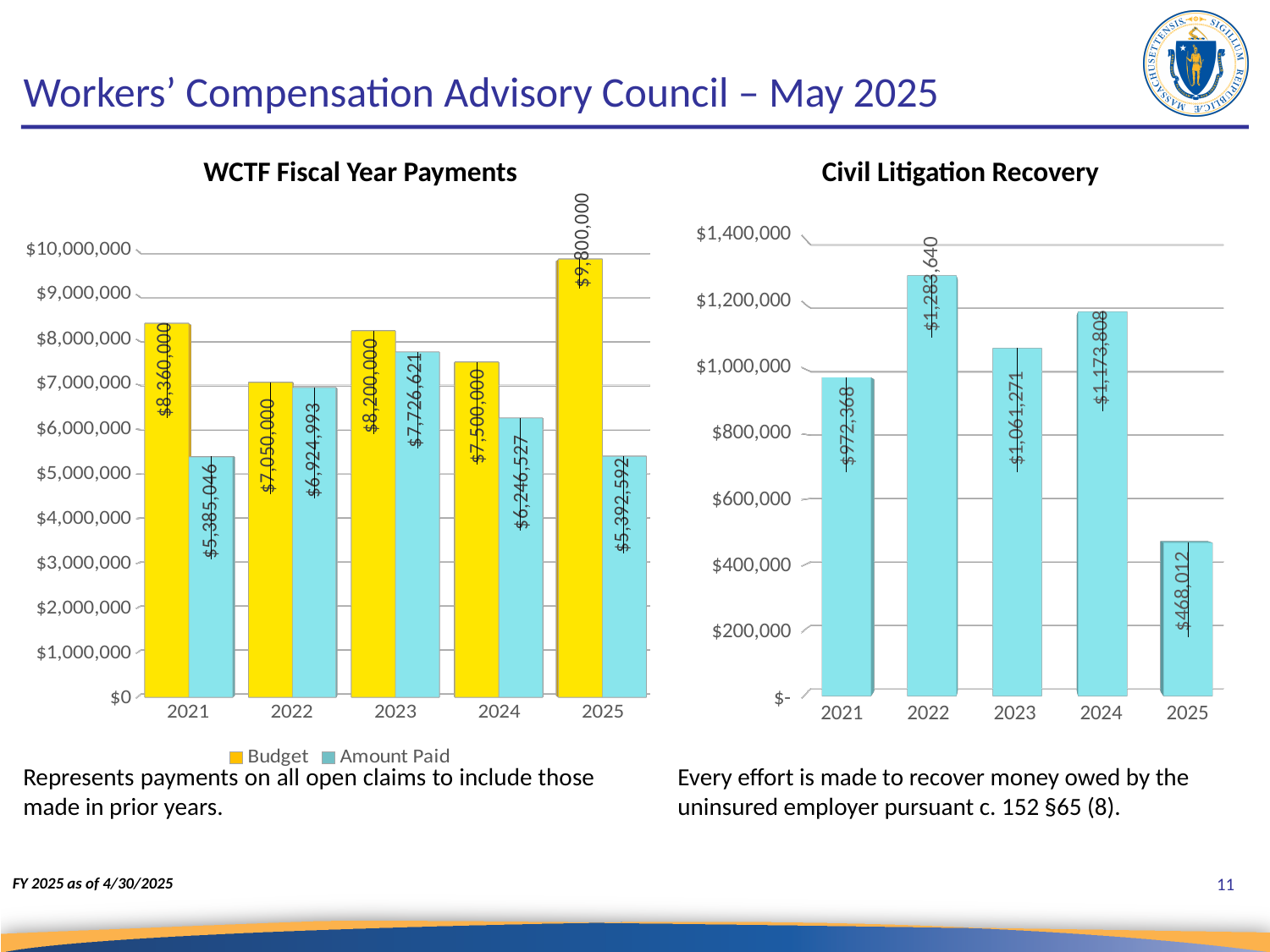
In the Civil Litigation Recovery chart, which year has the highest recovery? 2022 What kind of chart is the Civil Litigation Recovery chart? Bar chart In the WCTF Fiscal Year Payments chart, what is the Amount Paid for 2023? $7,726,621 In the Civil Litigation Recovery chart, what is the value for 2024? $1,173,808 In the WCTF Fiscal Year Payments chart, which is larger: the Budget for 2023 or the Budget for 2024? Budget for 2023 How many series does the legend of the WCTF Fiscal Year Payments chart list? 2 In the WCTF Fiscal Year Payments chart, what is the Budget value for 2025? $9,800,000 In the Civil Litigation Recovery chart, is the value for 2025 greater or less than $600,000? less In the WCTF Fiscal Year Payments chart, which year has the highest Budget? 2025 In the WCTF Fiscal Year Payments chart, what is the difference between the Budget and the Amount Paid for 2021? $2,974,954 In the Civil Litigation Recovery chart, what is the difference between the 2022 and 2025 values? $815,628 In the Civil Litigation Recovery chart, which year has the lowest recovery? 2025